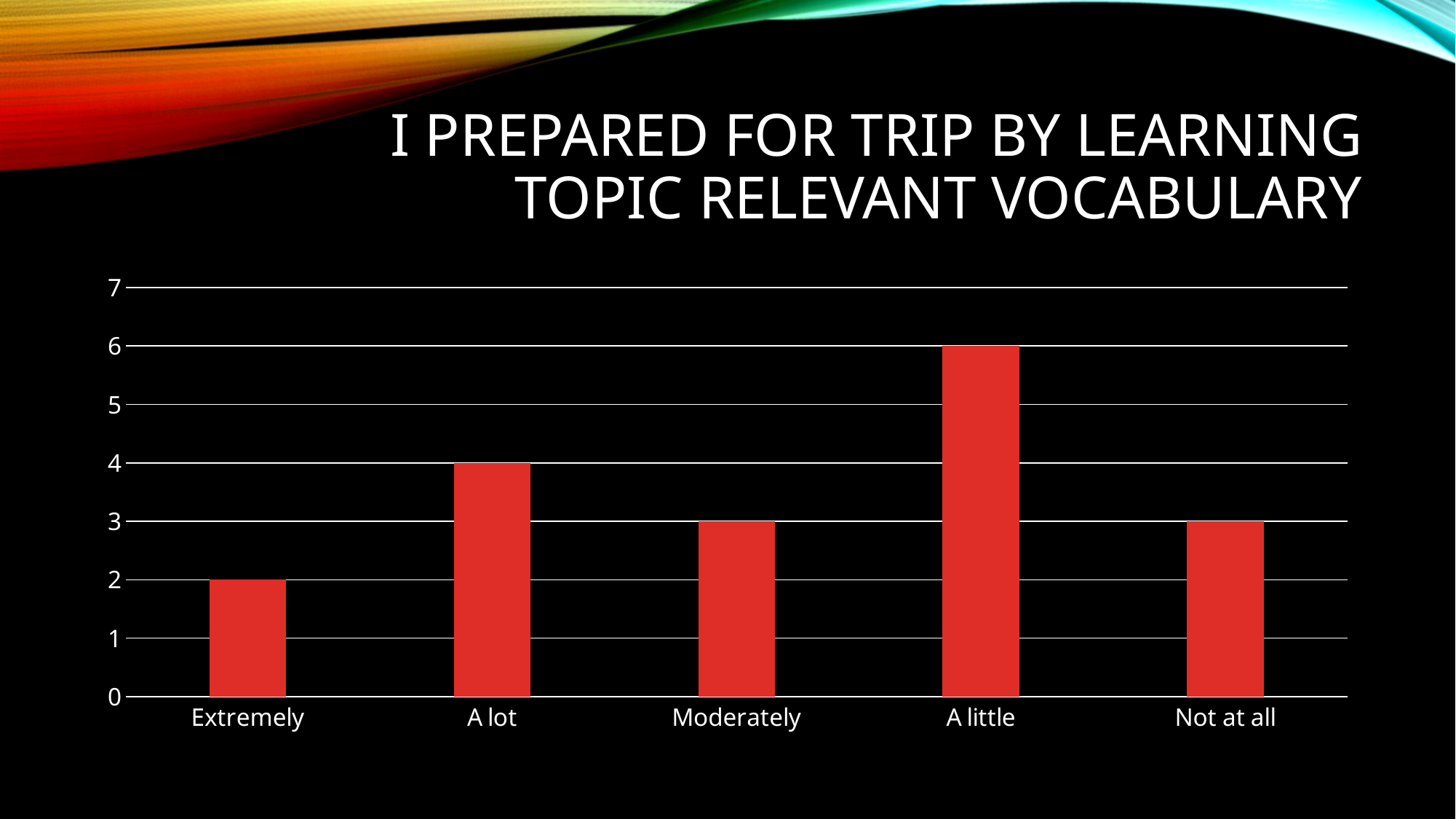
What is the value for "A little"? 6 What is the title of the slide? I prepared for trip by learning topic relevant vocabulary What is the value for "A lot"? 4 How many categories are shown on the x axis? 5 Which category has the highest value? A little Is the value for "A little" greater or less than 5? greater What is the value for "Extremely"? 2 What is the difference between the values for "A little" and "A lot"? 2 What colour are the bars in the chart? Red What kind of chart is shown on the slide? Bar chart Which category has the lowest value? Extremely Which is larger, the value for "A lot" or the value for "Moderately"? A lot